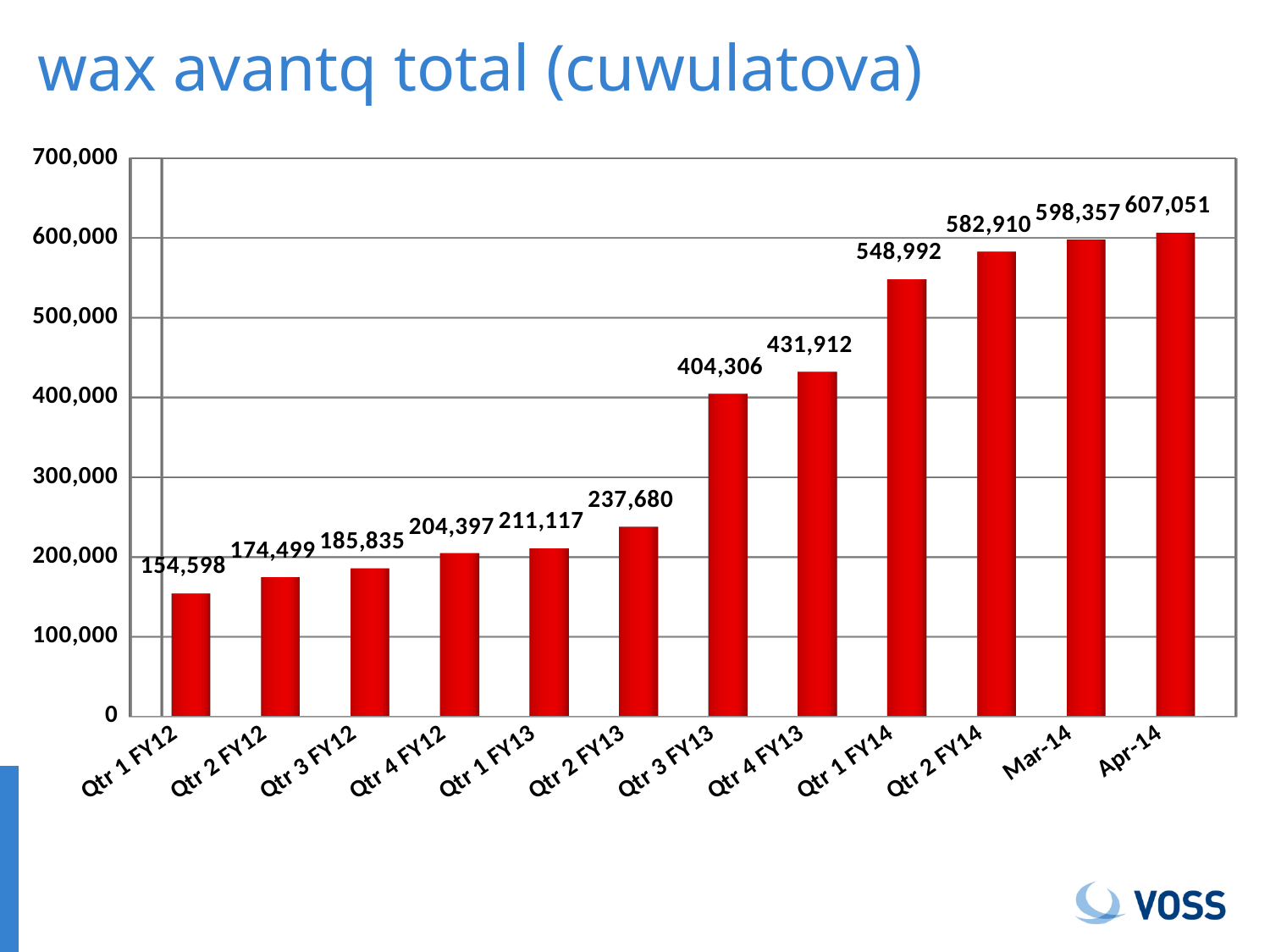
Is the value for Qtr 1 FY14 greater or less than 500,000? greater What is the difference between the values for Qtr 4 FY13 and Qtr 3 FY13? 27,606 Do the values rise or fall from Qtr 1 FY12 to Apr-14? rise Which category has the lowest value? Qtr 1 FY12 What is the value for Mar-14? 598,357 How many categories are shown on the x axis? 12 Which is larger, the value for Qtr 2 FY13 or the value for Qtr 1 FY14? Qtr 1 FY14 What is the difference between the values for Apr-14 and Qtr 1 FY12? 452,453 What is the value for Qtr 3 FY13? 404,306 Which category has the highest value? Apr-14 What kind of chart is shown on the slide? bar chart What is the value for Qtr 1 FY12? 154,598